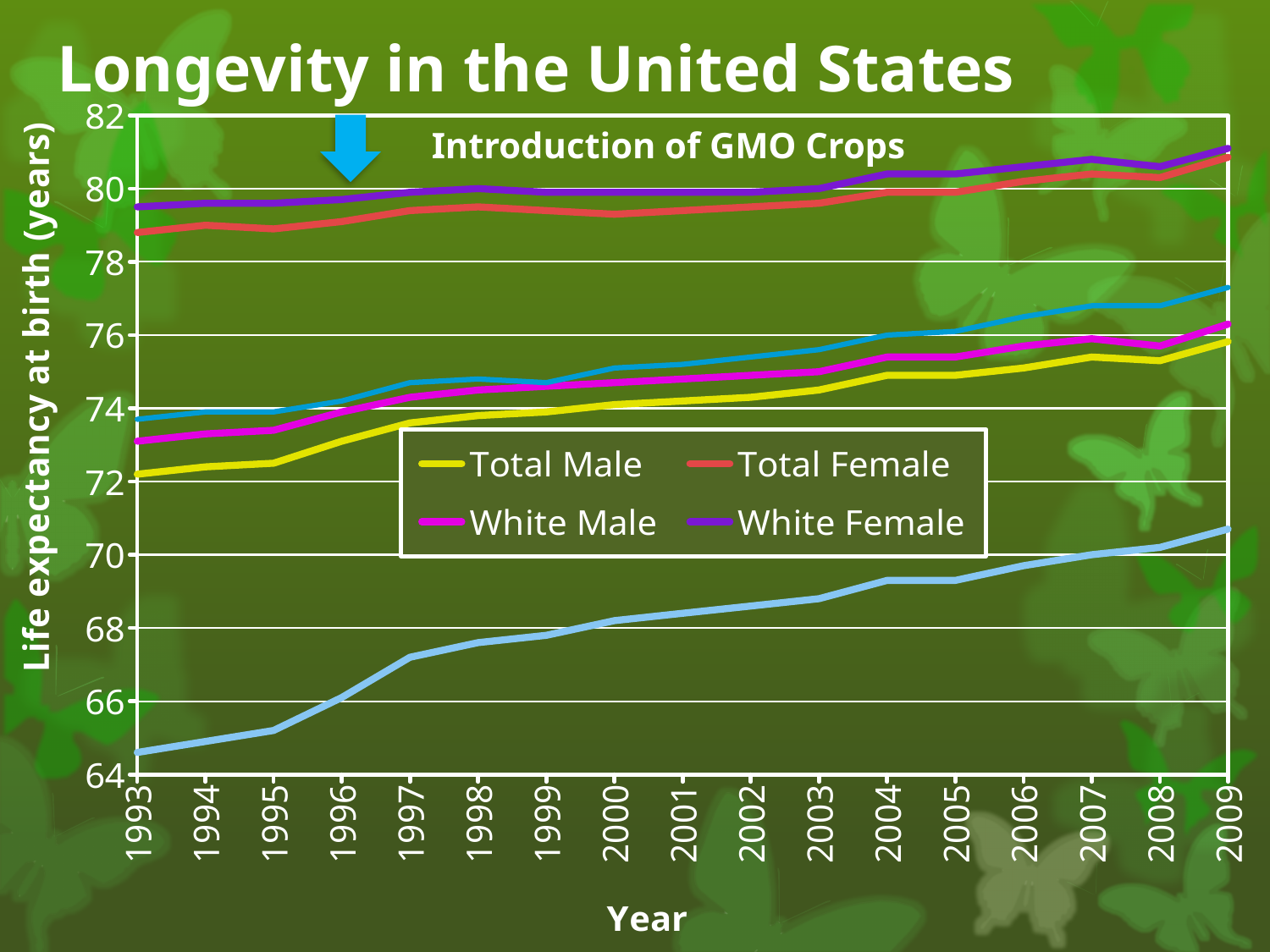
How many series does the legend list? 4 What event does the annotation with the blue arrow mark on the chart? Introduction of GMO Crops How many years are shown along the x axis? 17 Which legend series has the highest values across all years? White Female What kind of chart is shown on the slide? line chart Is the value for White Male in 2009 greater or less than 74? greater Is the value for White Female in 1993 greater or less than 80? less In 2000, which is higher: White Female or Total Female? White Female Is the value for Total Male in 1993 greater or less than 74? less Does the Total Male line rise or fall from 1993 to 2009? rise In 2009, which is higher: Total Female or Total Male? Total Female